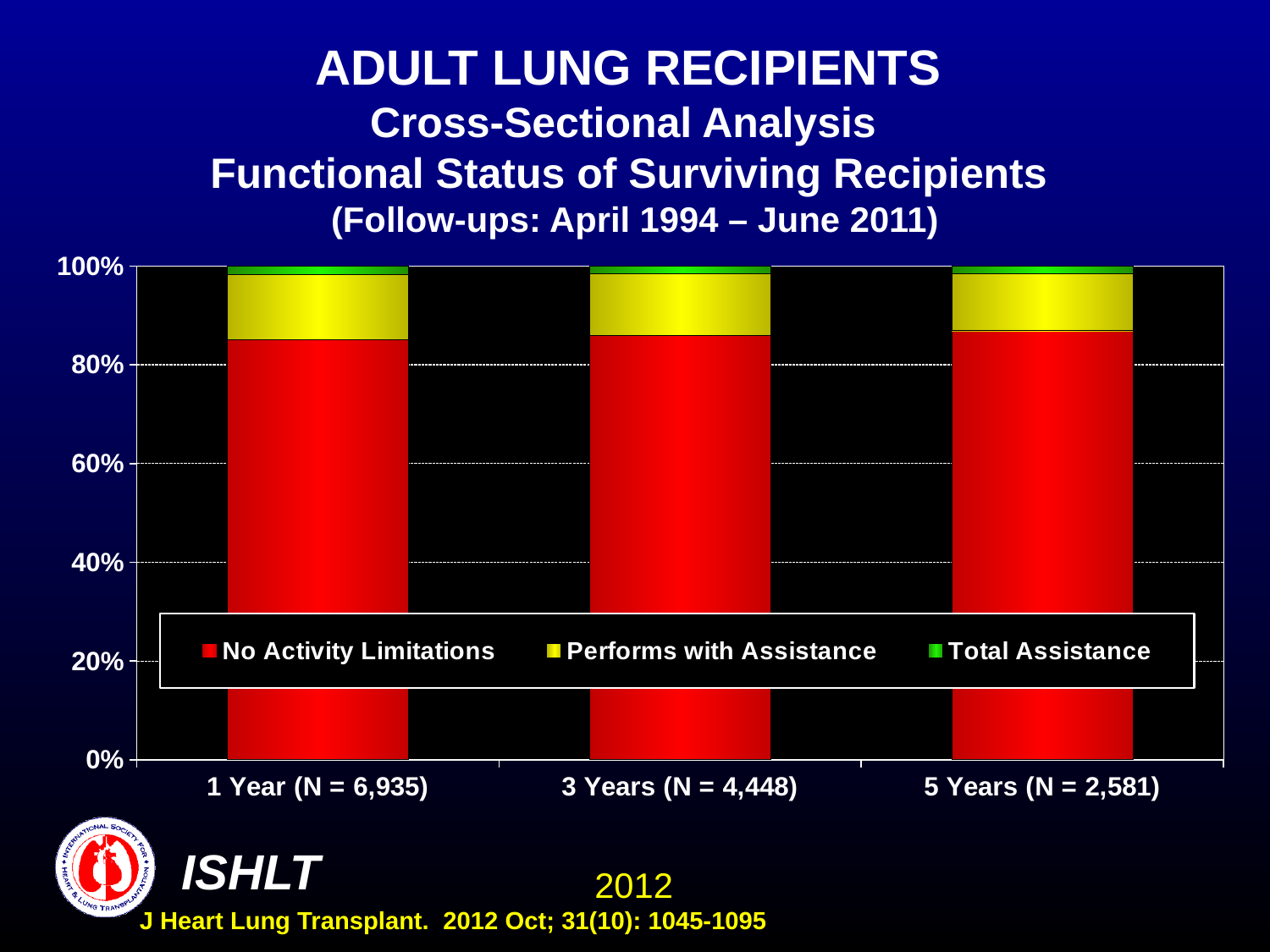
How many categories are shown on the x axis? 3 Is the value for Total Assistance at 3 Years greater or less than 20%? less What is the sample size (N) shown for the 3 Years category? 4,448 Is the value for No Activity Limitations at 5 Years greater or less than 80%? greater Which series makes up the smallest portion of each stacked bar? Total Assistance What is the total height of the stacked bar for 1 Year (N = 6,935)? 100% Is the value for No Activity Limitations at 1 Year greater or less than 80%? greater Which series is shown in red in the legend? No Activity Limitations What kind of chart is shown on the slide? Stacked bar chart Which series makes up the largest portion of each stacked bar? No Activity Limitations How many series does the legend list? 3